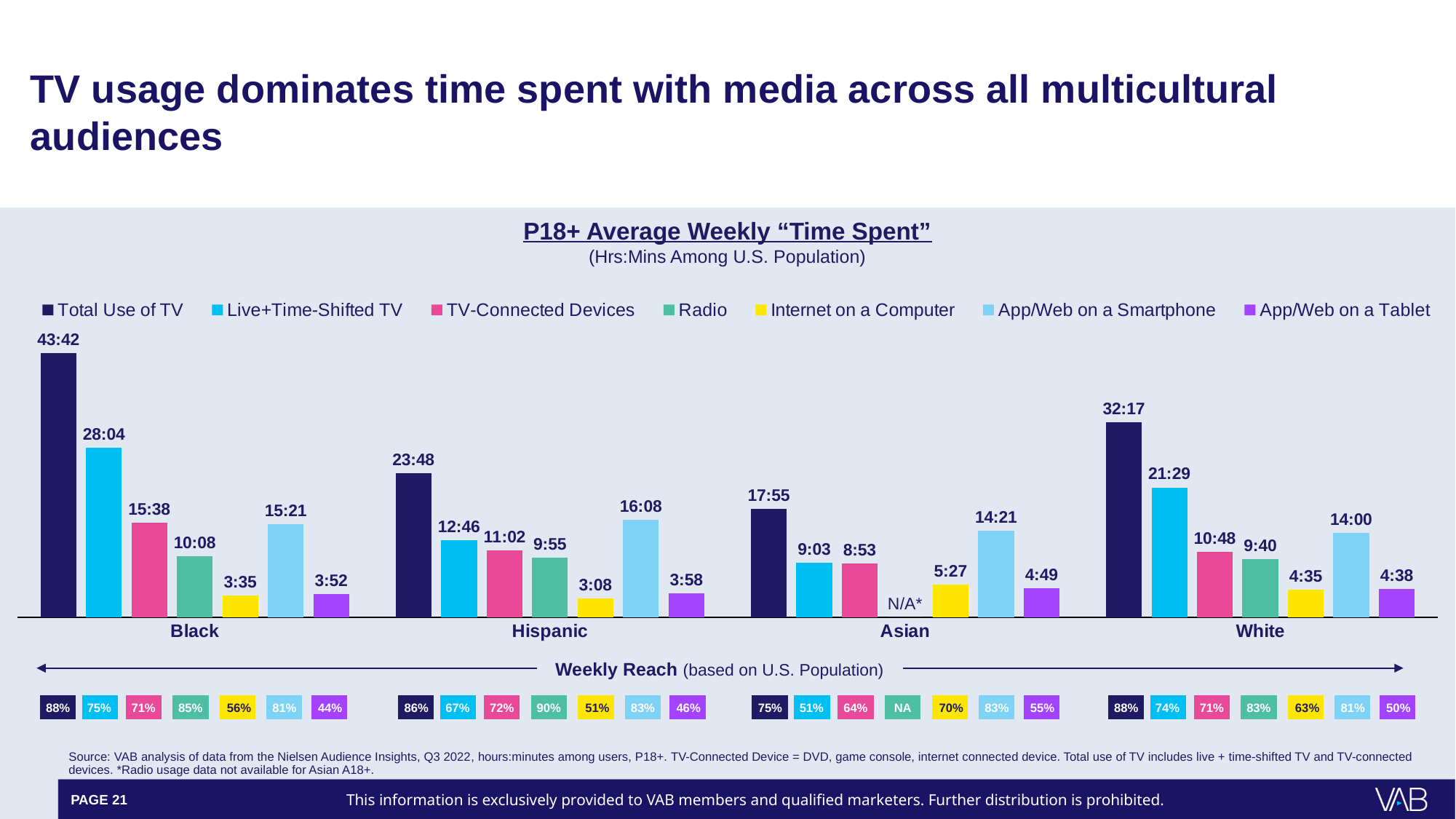
What kind of chart is shown on the slide? Bar chart How many series does the legend list? 7 What is the Live+Time-Shifted TV value for the White audience? 21:29 For the Hispanic audience, which is larger: TV-Connected Devices or Radio? TV-Connected Devices Which audience group has the lowest Total Use of TV? Asian What is the Total Use of TV value for the Black audience? 43:42 How many audience groups are shown on the x axis? 4 What is the title of the chart? P18+ Average Weekly "Time Spent" Which audience group has the highest Total Use of TV? Black What is the App/Web on a Smartphone value for the Hispanic audience? 16:08 What is the difference in Total Use of TV between the Black audience and the White audience? 11:25 What is shown for Radio in the Asian audience group? N/A*